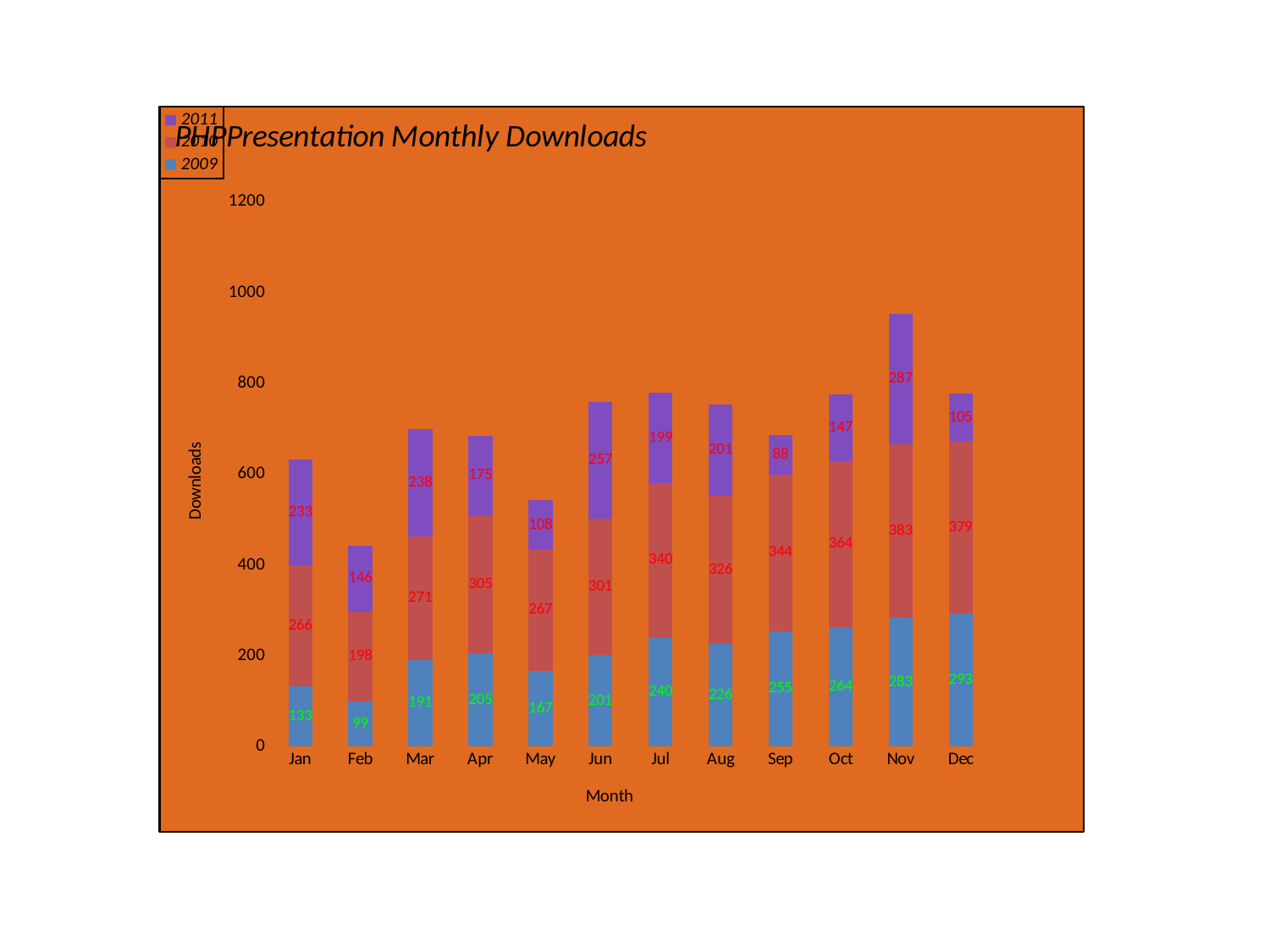
Which is larger, the 2011 downloads for Jun or for Apr? Jun What kind of chart is shown on the slide? stacked bar chart What is the total downloads for Nov across all three years? 953 Which month has the highest 2009 downloads? Dec How many series does the legend list? 3 What is the difference between the 2010 downloads for Oct and Feb? 166 How many months are shown on the x axis? 12 What is the 2011 downloads value for Sep? 88 What is the 2009 downloads value for Jul? 240 Which month has the lowest 2011 downloads? Sep Is the total stacked bar for Feb greater or less than 600? less What is the 2010 downloads value for Nov? 383